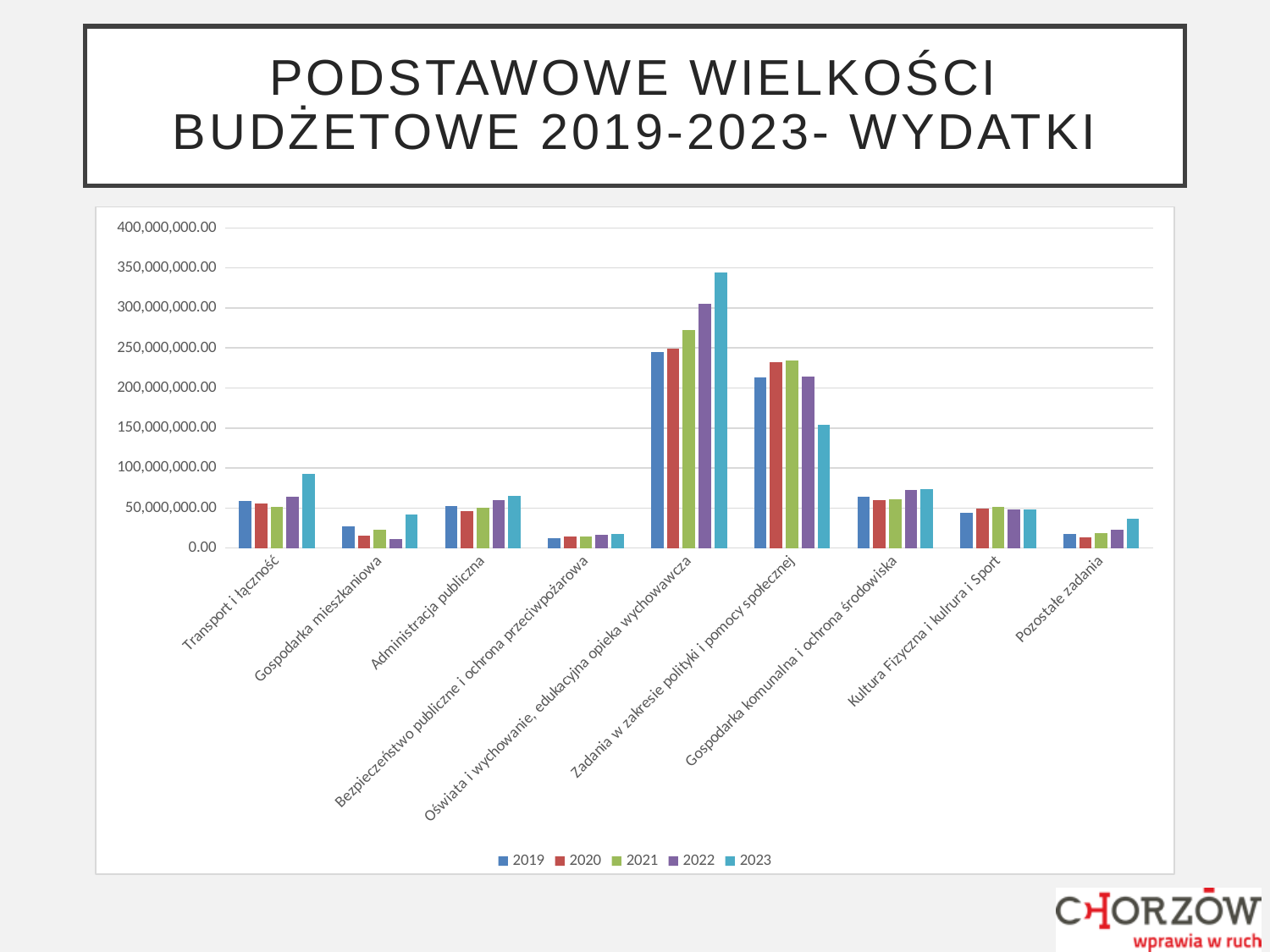
How many categories are shown on the x axis? 9 Which category has the lowest value for 2019? Bezpieczeństwo publiczne i ochrona przeciwpożarowa What kind of chart is shown on the slide? bar chart Is the 2023 value for Zadania w zakresie polityki i pomocy społecznej greater or less than 200,000,000.00? less Which is larger for 2023: Transport i łączność or Gospodarka komunalna i ochrona środowiska? Transport i łączność Is the 2023 value for Oświata i wychowanie, edukacyjna opieka wychowawcza greater or less than 300,000,000.00? greater How many series does the legend list? 5 Which is larger for 2019: Oświata i wychowanie, edukacyjna opieka wychowawcza or Zadania w zakresie polityki i pomocy społecznej? Oświata i wychowanie, edukacyjna opieka wychowawcza Which years are listed in the legend? 2019, 2020, 2021, 2022, 2023 Do the values for Oświata i wychowanie, edukacyjna opieka wychowawcza rise or fall from 2019 to 2023? rise Which category has the highest value for 2023? Oświata i wychowanie, edukacyjna opieka wychowawcza Is the 2023 value for Transport i łączność greater or less than 100,000,000.00? less